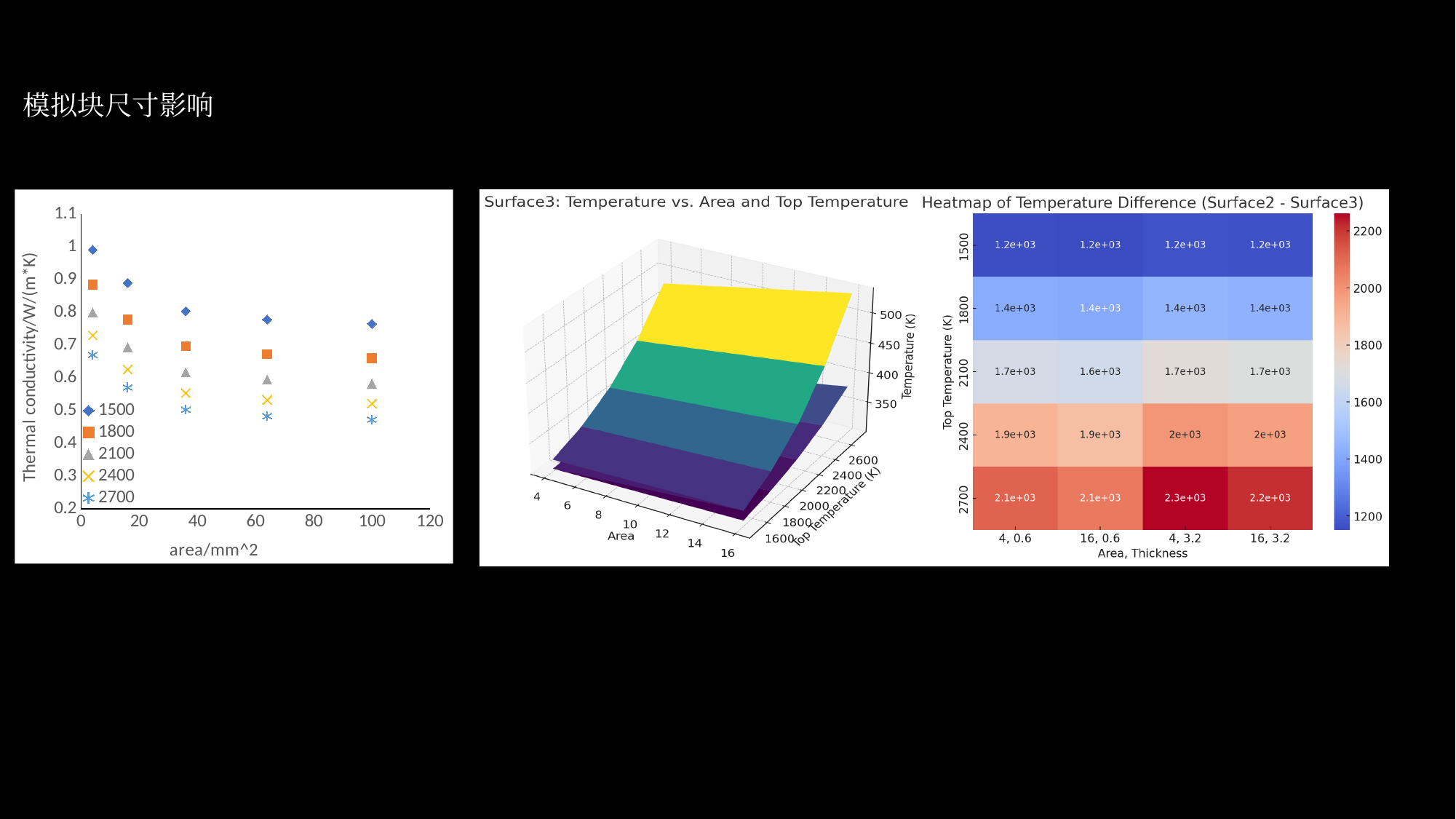
In the heatmap chart, which Area, Thickness column contains the highest value? 4, 3.2 In the left chart, which series has the highest thermal conductivity values overall? 1500 In the heatmap chart, what is the temperature difference for Area, Thickness 4, 3.2 at Top Temperature 2700? 2.3e+03 In the left chart, at area 100, which series has the larger thermal conductivity, 1500 or 2700? 1500 In the left chart, is the thermal conductivity of the 1500 series at the smallest area greater or less than 0.9? greater In the left chart, do the thermal conductivity values rise or fall as area increases? fall In the heatmap chart, how many Area, Thickness categories are shown on the x axis? 4 In the heatmap chart, what is the temperature difference for Area, Thickness 16, 0.6 at Top Temperature 1500? 1.2e+03 What is the title of the middle chart? Surface3: Temperature vs. Area and Top Temperature What kind of chart is the left chart (Thermal conductivity vs area)? scatter chart In the left chart, how many series does the legend list? 5 In the left chart, is the thermal conductivity of the 2700 series at area 100 greater or less than 0.5? less